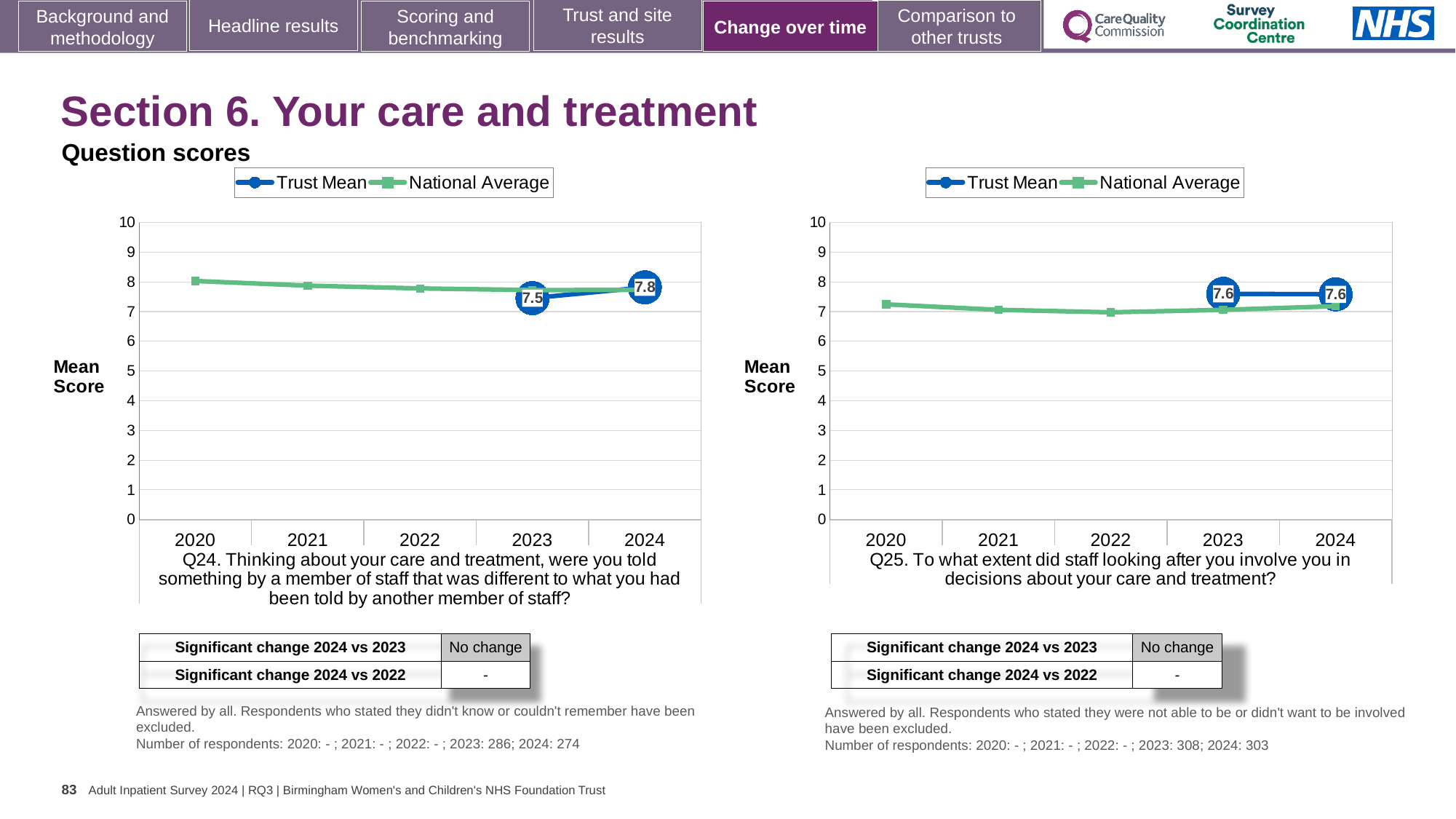
In the Q24 chart on the left, what is the Trust Mean score for 2023? 7.5 In the Q24 chart on the left, by how much did the Trust Mean change from 2023 to 2024? 0.3 In the Q24 chart on the left, is the National Average for 2020 greater or less than 7? greater How many years are shown on the x axis of the Q25 chart on the right? 5 In the Q25 chart on the right, did the Trust Mean rise, fall or stay the same from 2023 to 2024? stay the same In the Q25 chart on the right, what is the Trust Mean score for 2024? 7.6 In the Q24 chart on the left, did the Trust Mean rise or fall from 2023 to 2024? rise In the Q24 chart on the left, what is the Trust Mean score for 2024? 7.8 What type of chart is the Q25 chart on the right? line chart How many series does the legend of the Q24 chart on the left list? 2 In the Q25 chart on the right, is the National Average for 2020 greater or less than 8? less In the Q24 chart on the left, which year has the higher Trust Mean, 2023 or 2024? 2024